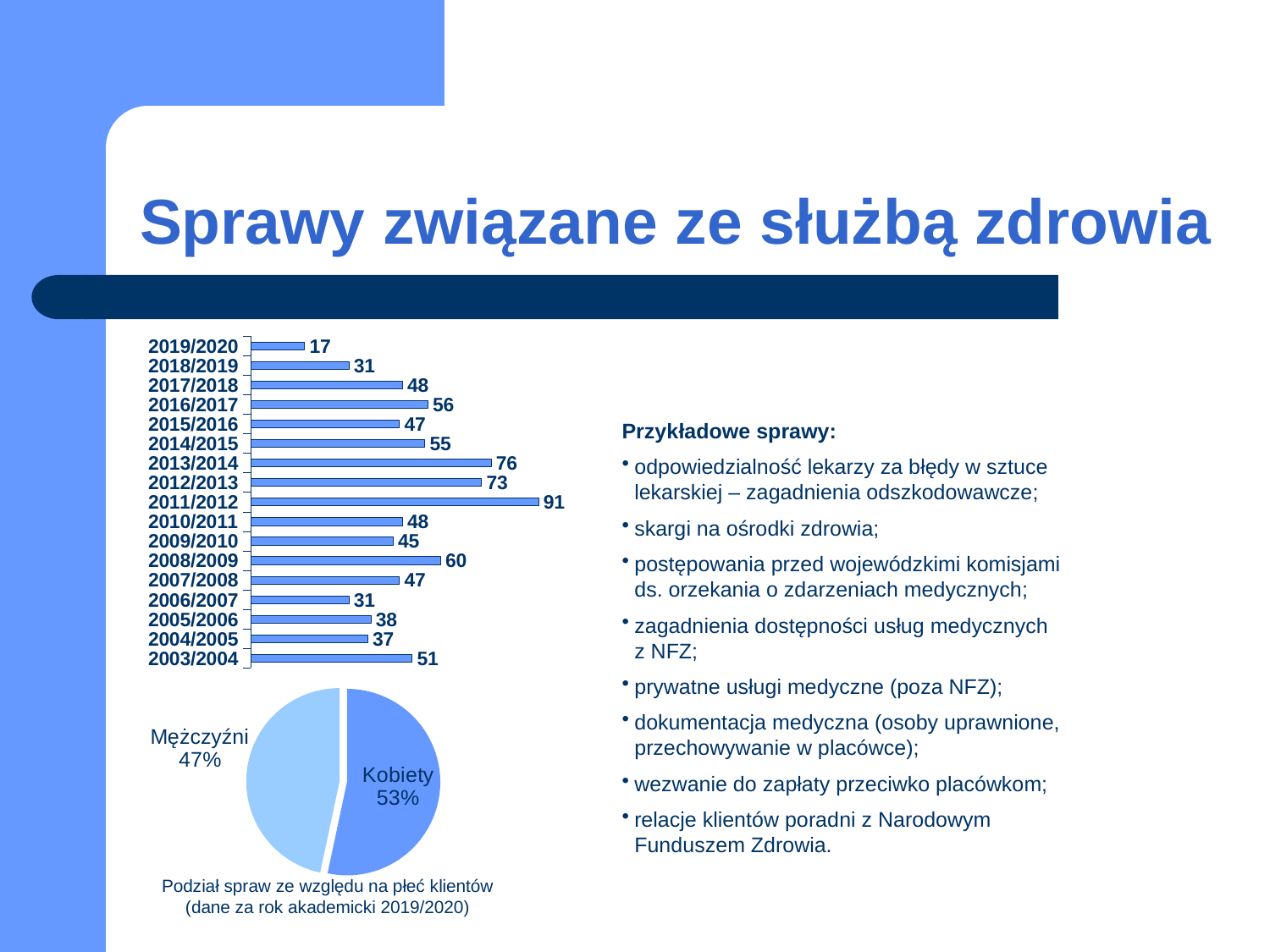
In the bar chart at the top left, which academic year has the lowest value? 2019/2020 In the pie chart at the bottom left, what share is labelled Kobiety? 53% In the bar chart at the top left, how many academic years are shown? 17 In the bar chart at the top left, what is the value for 2008/2009? 60 In the bar chart at the top left, what is the value for 2011/2012? 91 In the bar chart at the top left, which is larger, the value for 2016/2017 or the value for 2014/2015? 2016/2017 In the bar chart at the top left, what is the difference between the values for 2013/2014 and 2012/2013? 3 In the bar chart at the top left, what is the value for 2019/2020? 17 What kind of chart is the chart at the bottom left of the slide? Pie chart What kind of chart is the chart at the top left of the slide? Bar chart In the bar chart at the top left, which academic year has the highest value? 2011/2012 In the pie chart at the bottom left, what share is labelled Mężczyźni? 47%